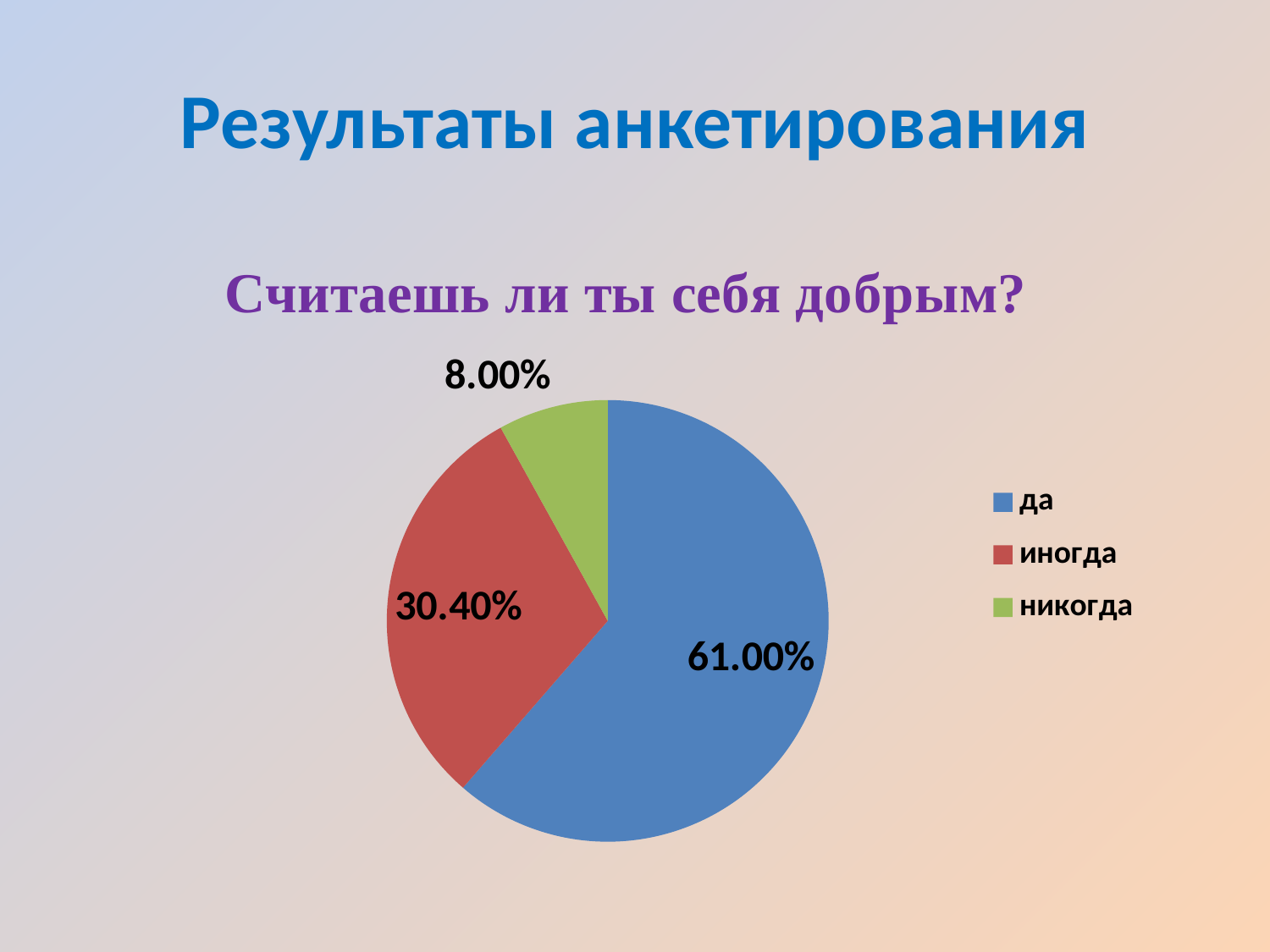
How many slices does the pie chart have? 3 What question is the pie chart about, according to its title? Считаешь ли ты себя добрым? What colour is the slice for "никогда"? green Which answer has the smallest share of the pie? никогда What is the difference between the shares for "да" and "иногда"? 30.60% Which is larger: the share for "иногда" or the share for "никогда"? иногда What percentage of respondents answered "никогда"? 8.00% What is the difference between the shares for "иногда" and "никогда"? 22.40% Which answer has the largest share of the pie? да What percentage of respondents answered "иногда"? 30.40% What type of chart is shown on the slide? pie chart What percentage of respondents answered "да"? 61.00%